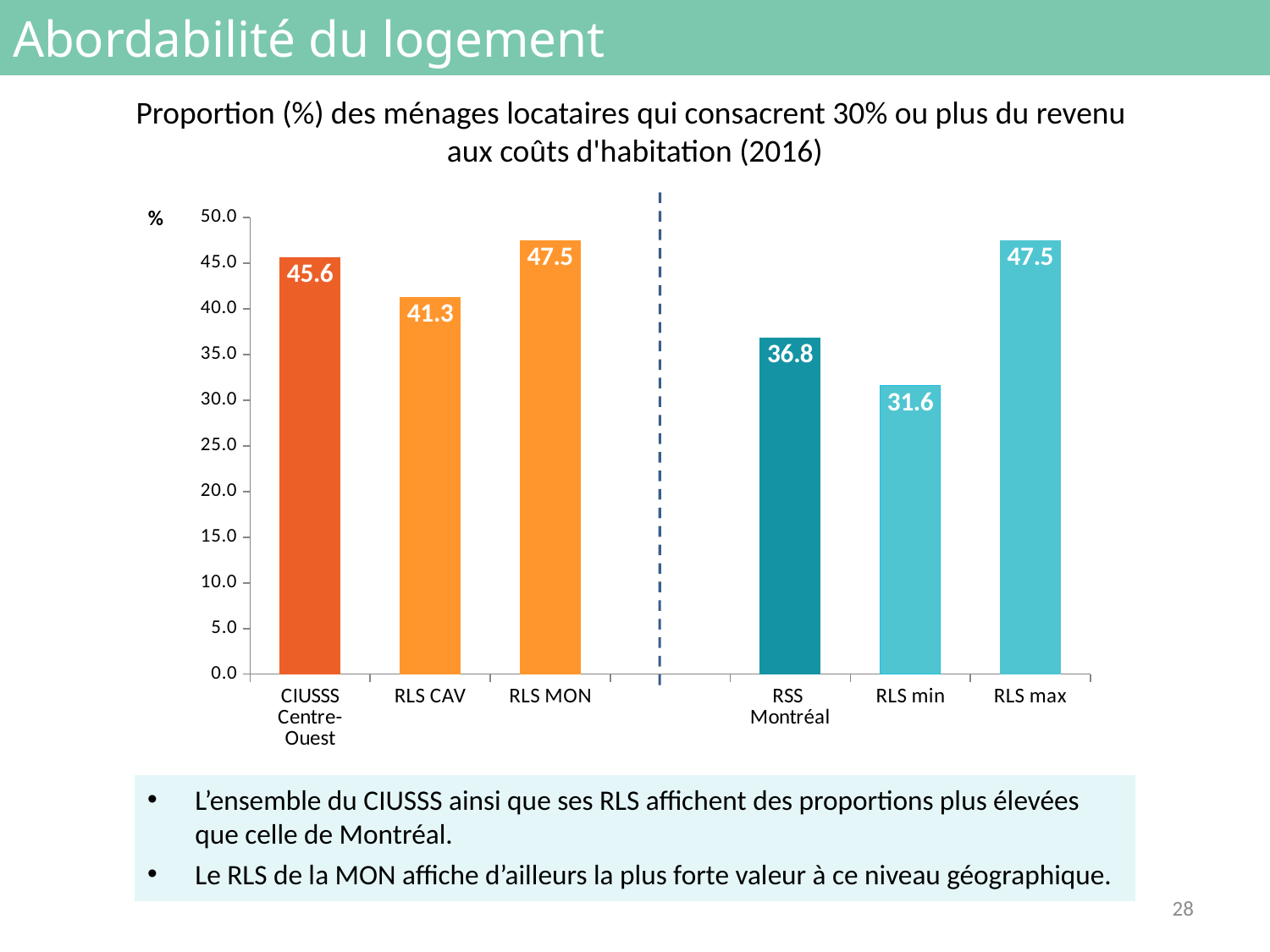
What is the value for RLS min? 31.6 What is the value for RLS CAV? 41.3 What is the value for CIUSSS Centre-Ouest? 45.6 Which is larger, the value for RLS CAV or the value for RSS Montréal? RLS CAV What kind of chart is shown on the slide? Bar chart What is the value for RSS Montréal? 36.8 What is the difference between the values for RLS MON and RSS Montréal? 10.7 Which category has the lowest value? RLS min How many bars are shown in the chart? 6 Is the value for RLS min greater or less than 35.0? less What is the difference between the values for CIUSSS Centre-Ouest and RLS CAV? 4.3 What year is given in the chart title? 2016